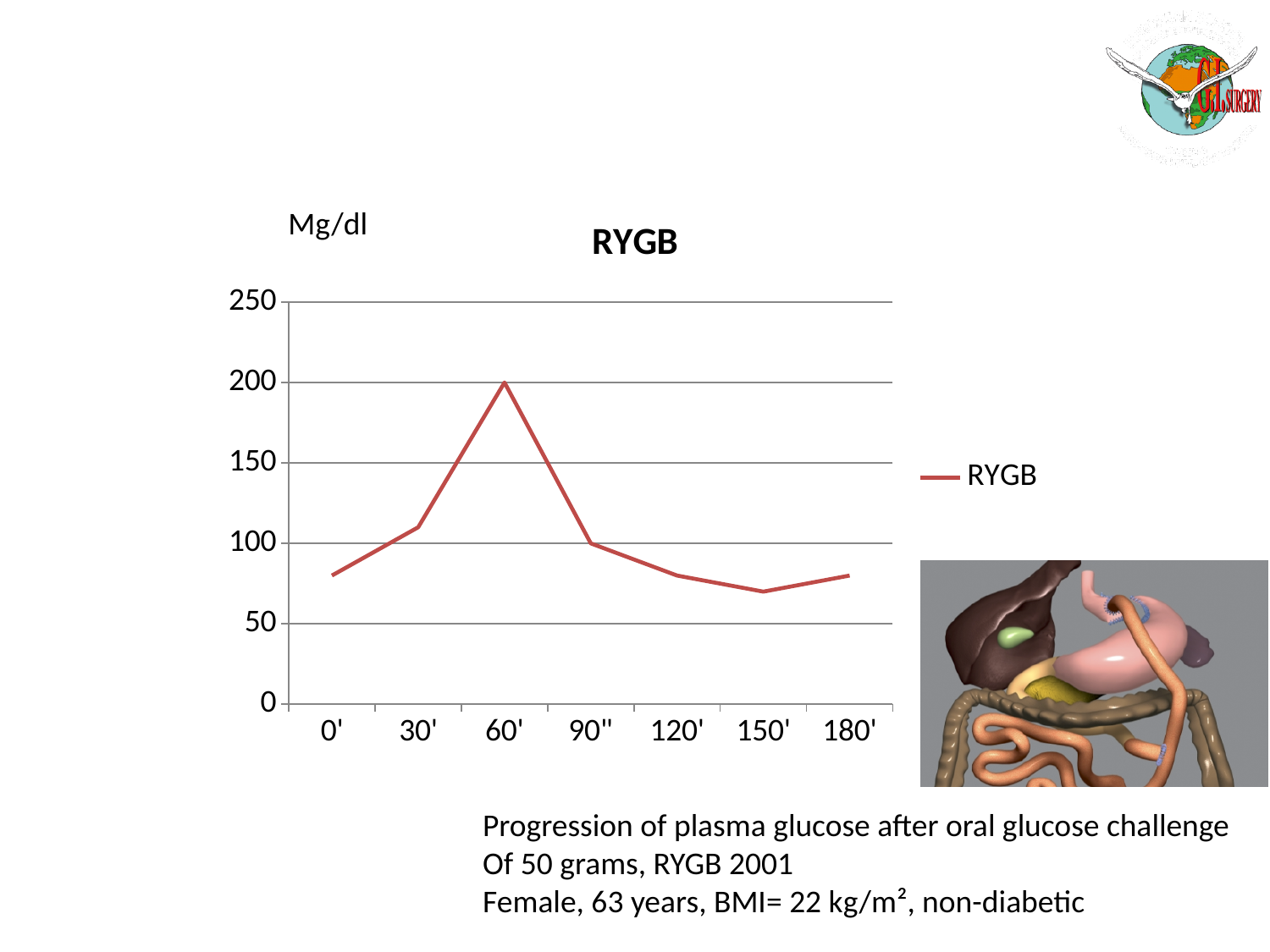
What kind of chart is shown on the slide? line chart How many series does the legend list? 1 At which time point is the plasma glucose value lowest? 150' What is the title of the chart? RYGB How many time points are plotted on the x axis? 7 What is the value at 60'? 200 Do the values rise or fall from 60' to 150'? fall At which time point is the plasma glucose value highest? 60' Is the value at 0' greater or less than 100? less Is the value at 30' greater or less than 100? greater Which is larger, the value at 30' or the value at 120'? 30' What unit is shown above the y axis of the chart? Mg/dl